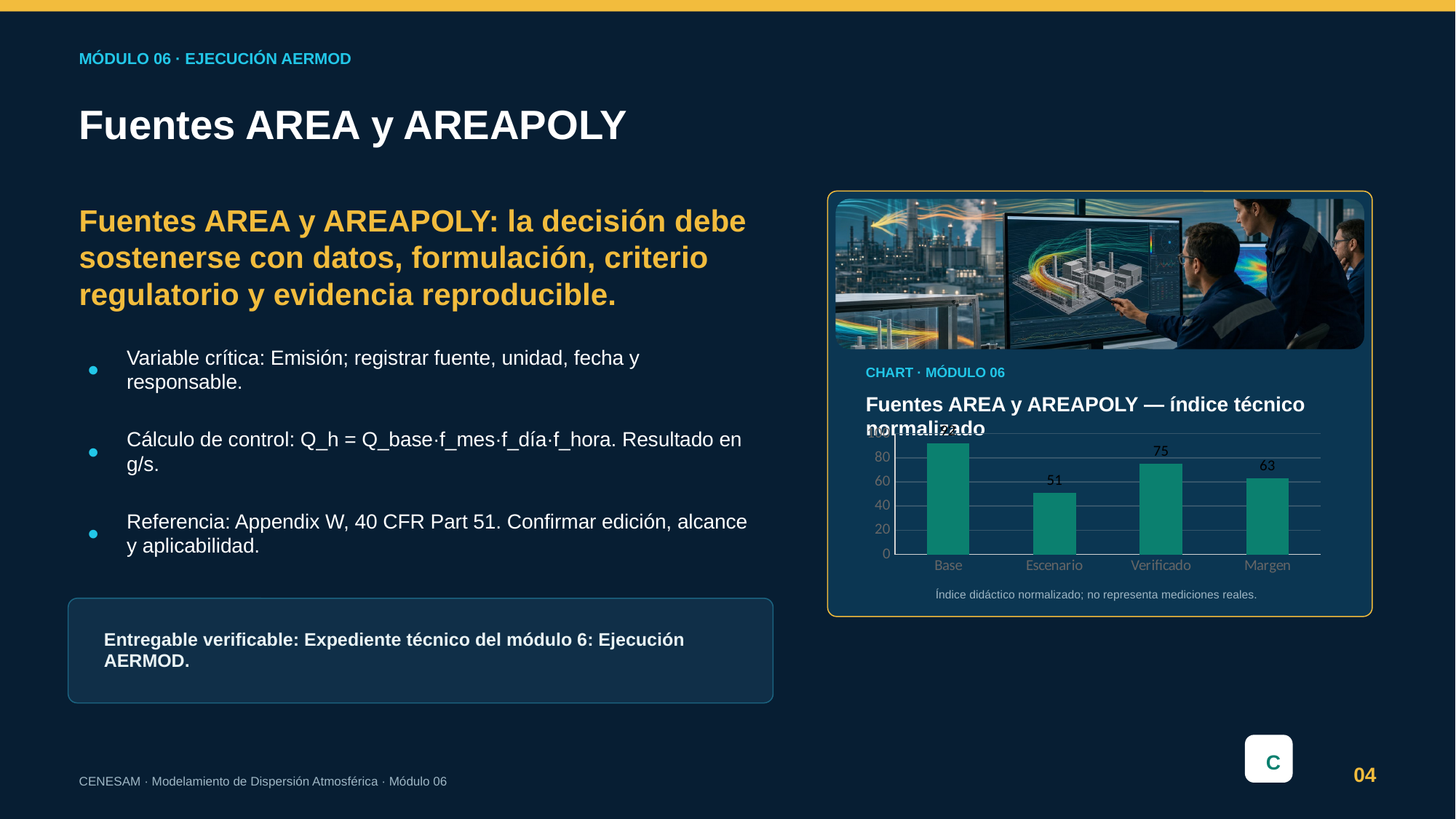
How many categories are shown on the x axis? 4 Which category has the highest value? Base What is the value for Margen? 63 What is the difference between the values for Verificado and Escenario? 24 What is the value for Verificado? 75 Which is larger, the value for Margen or the value for Escenario? Margen What is the value for Escenario? 51 What is the title of the chart? Fuentes AREA y AREAPOLY — índice técnico normalizado What is the difference between the values for Verificado and Margen? 12 Is the value for Base greater or less than 80? greater Which category has the lowest value? Escenario What kind of chart is shown? Bar chart